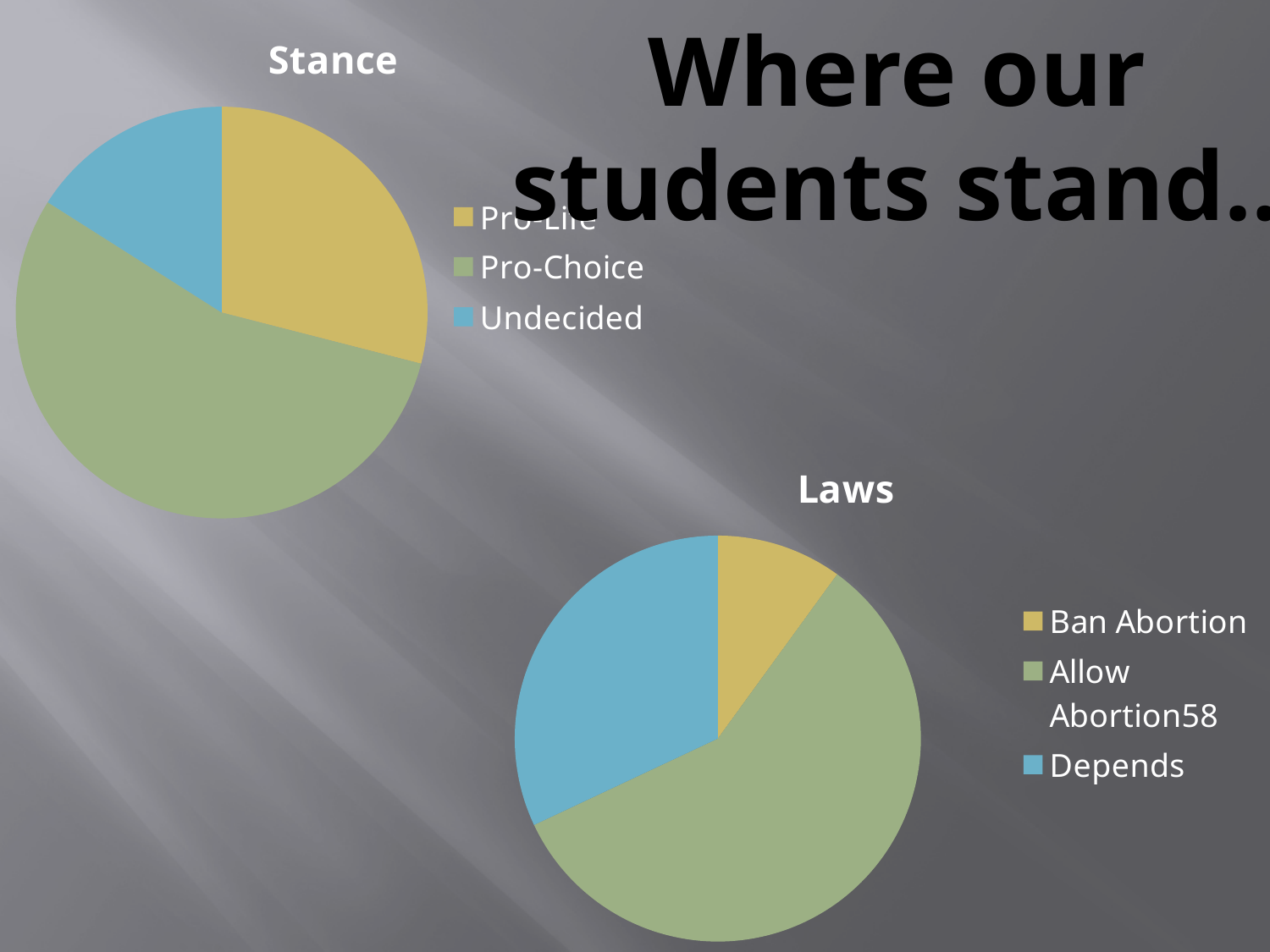
In the "Stance" chart, which category has the largest slice? Pro-Choice In the "Laws" chart, which category has the smallest slice? Ban Abortion What kind of chart is the "Laws" chart? pie chart In the "Laws" chart, how many categories does the legend list? 3 In the "Laws" chart, which category has the largest slice? Allow Abortion58 In the "Stance" chart, which slice is larger: Pro-Life or Undecided? Pro-Life What is the title of the pie chart in the lower right of the slide? Laws In the "Stance" chart, which category has the smallest slice? Undecided What kind of chart is the "Stance" chart? pie chart In the "Stance" chart, how many slices does the pie have? 3 In the "Laws" chart, which slice is larger: Depends or Ban Abortion? Depends In the "Stance" chart, what colour is the Undecided slice? blue